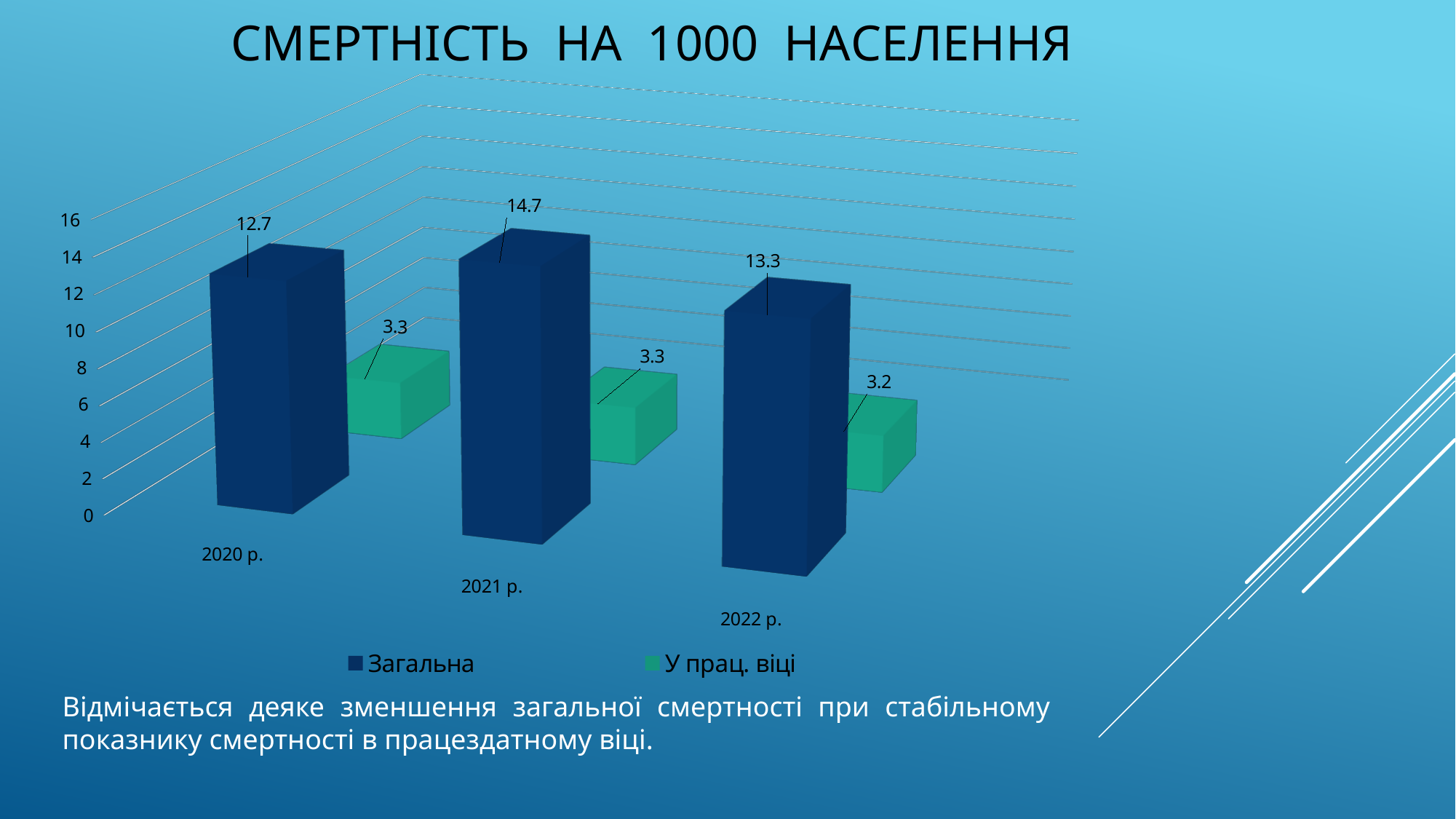
What kind of chart is shown on the slide? Bar chart How many years are shown on the x axis? 3 How many series does the legend list? 2 What is the difference between the Загальна values for 2021 р. and 2022 р.? 1.4 What is the value of the Загальна series for 2020 р.? 12.7 Which is larger: the Загальна value for 2020 р. or for 2022 р.? 2022 р. In which year is the Загальна value lowest? 2020 р. What is the title of the chart? СМЕРТНІСТЬ НА 1000 НАСЕЛЕННЯ What is the difference between the Загальна and У прац. віці values for 2020 р.? 9.4 In which year is the Загальна value highest? 2021 р. What is the value of the Загальна series for 2021 р.? 14.7 What is the value of the У прац. віці series for 2022 р.? 3.2